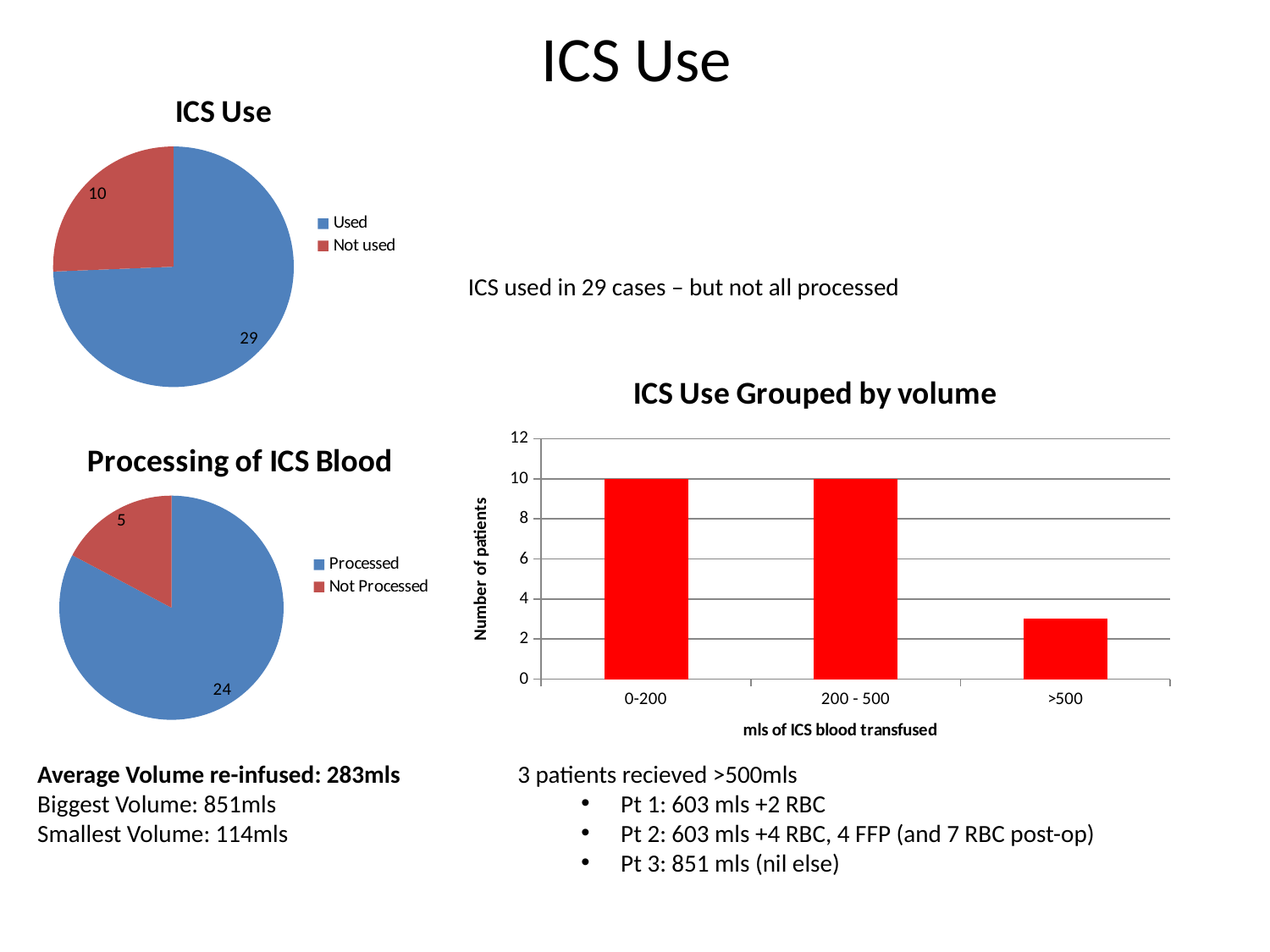
In the 'Processing of ICS Blood' pie chart, what is the value for 'Processed'? 24 In the 'ICS Use Grouped by volume' chart, which category has the lowest number of patients? >500 In the 'ICS Use Grouped by volume' chart, how many categories are shown on the x axis? 3 In the 'Processing of ICS Blood' pie chart, what is the value for 'Not Processed'? 5 In the 'ICS Use Grouped by volume' chart, is the value for '>500' greater or less than 4? less In the 'ICS Use' pie chart, what is the value for 'Used'? 29 In the 'ICS Use' pie chart, what is the difference between 'Used' and 'Not used'? 19 In the 'ICS Use' pie chart, what is the total of the two slices? 39 What kind of chart is 'ICS Use Grouped by volume'? bar chart In the 'ICS Use Grouped by volume' chart, how many patients are in the '0-200' group? 10 In the 'ICS Use' pie chart, what is the value for 'Not used'? 10 In the 'Processing of ICS Blood' pie chart, which slice is larger, 'Processed' or 'Not Processed'? Processed